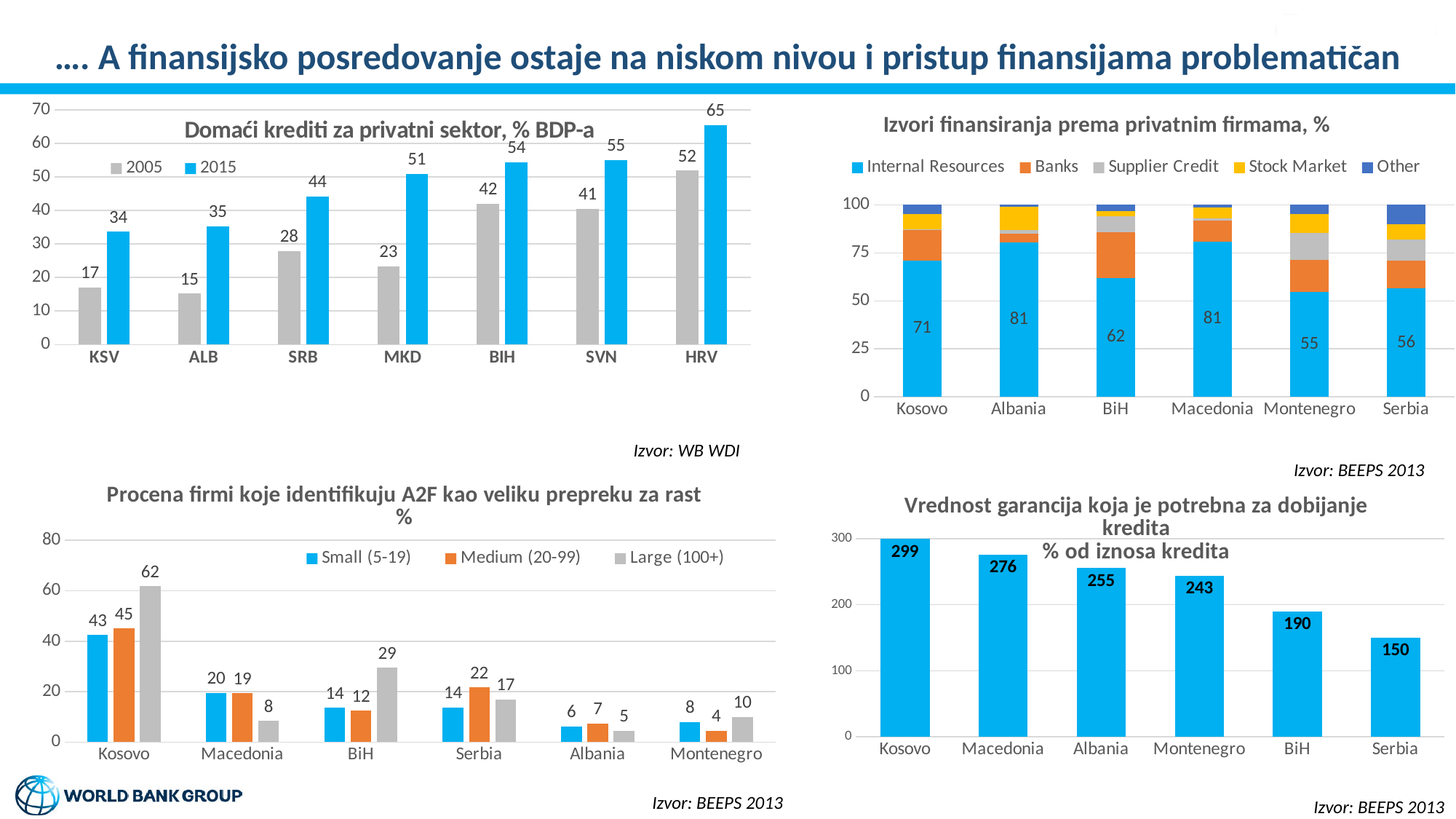
In the chart 'Domaći krediti za privatni sektor, % BDP-a', what is the 2015 value for SRB? 44 In the chart 'Vrednost garancija koja je potrebna za dobijanje kredita', what is the difference between Kosovo and Serbia? 149 In the chart 'Procena firmi koje identifikuju A2F kao veliku prepreku za rast %', which is larger for Serbia: Small (5-19) or Medium (20-99)? Medium (20-99) In the chart 'Procena firmi koje identifikuju A2F kao veliku prepreku za rast %', what is the value for Large (100+) firms in BiH? 29 In the chart 'Domaći krediti za privatni sektor, % BDP-a', what is the difference between the 2015 and 2005 values for MKD? 28 What type of chart is 'Vrednost garancija koja je potrebna za dobijanje kredita'? Bar chart In the chart 'Izvori finansiranja prema privatnim firmama, %', which country has the lowest Internal Resources value? Montenegro In the chart 'Domaći krediti za privatni sektor, % BDP-a', how many countries are shown on the x axis? 7 In the chart 'Domaći krediti za privatni sektor, % BDP-a', which country has the highest 2015 value? HRV In the chart 'Izvori finansiranja prema privatnim firmama, %', what is the Internal Resources value for Montenegro? 55 In the chart 'Izvori finansiranja prema privatnim firmama, %', how many series does the legend list? 5 In the chart 'Vrednost garancija koja je potrebna za dobijanje kredita', what is the value for Albania? 255